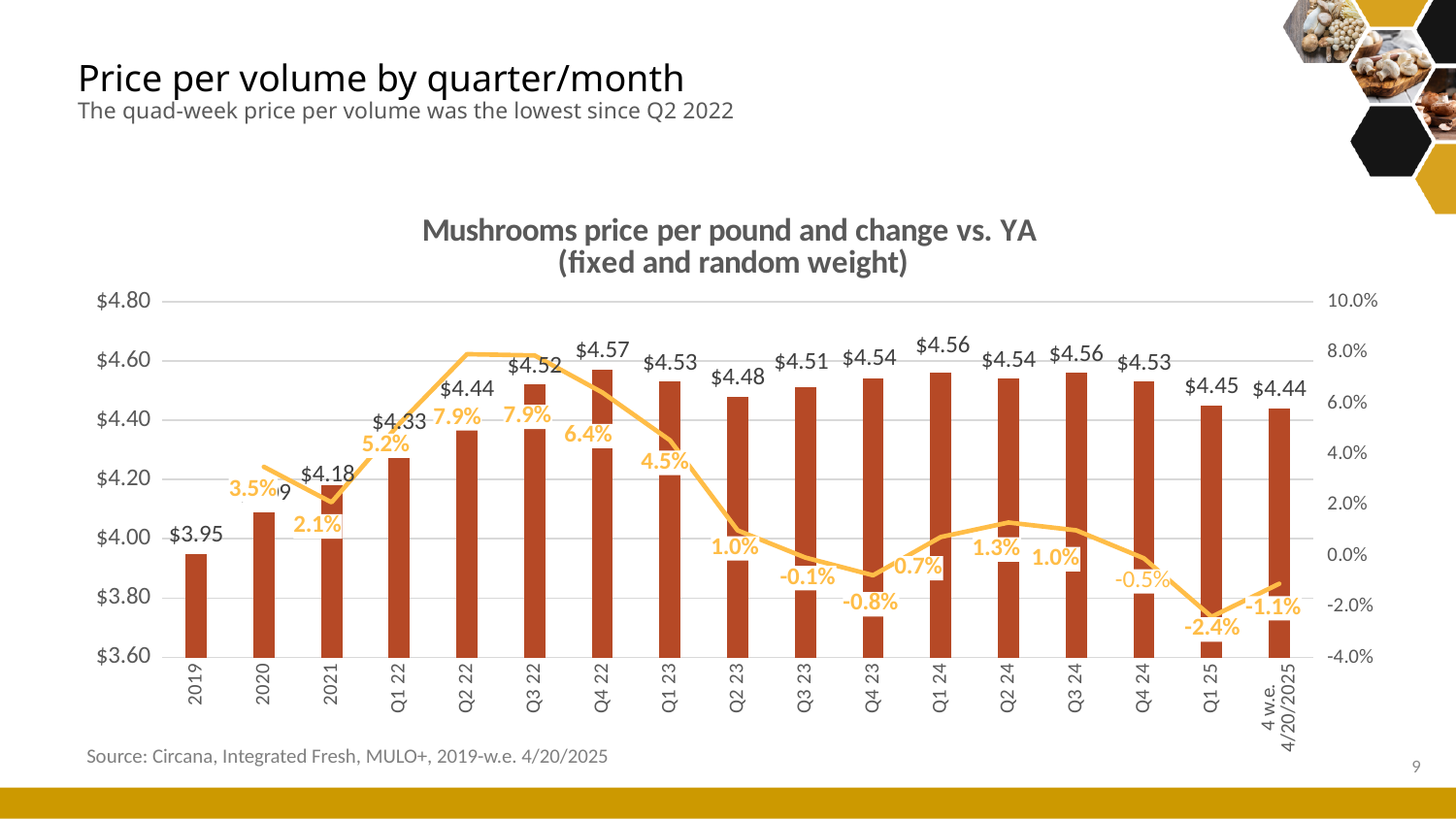
What is the change vs. YA shown for Q1 25? -2.4% What is the difference between the price per pound in Q4 22 and in 2019? $0.62 What is the price per pound shown for the 4 w.e. 4/20/2025 period? $4.44 How many periods are shown on the x axis? 17 What is the mushroom price per pound shown for Q4 22? $4.57 What kind of chart is this? Combination bar and line chart Which has the higher price per pound, Q1 24 or Q4 24? Q1 24 What is the price per pound shown for Q1 25? $4.45 Which period has the lowest change vs. YA on the line? Q1 25 Which period has the highest price per pound? Q4 22 Which period has the lowest price per pound? 2019 Does the price per pound rise or fall from 2019 to Q4 22? Rise